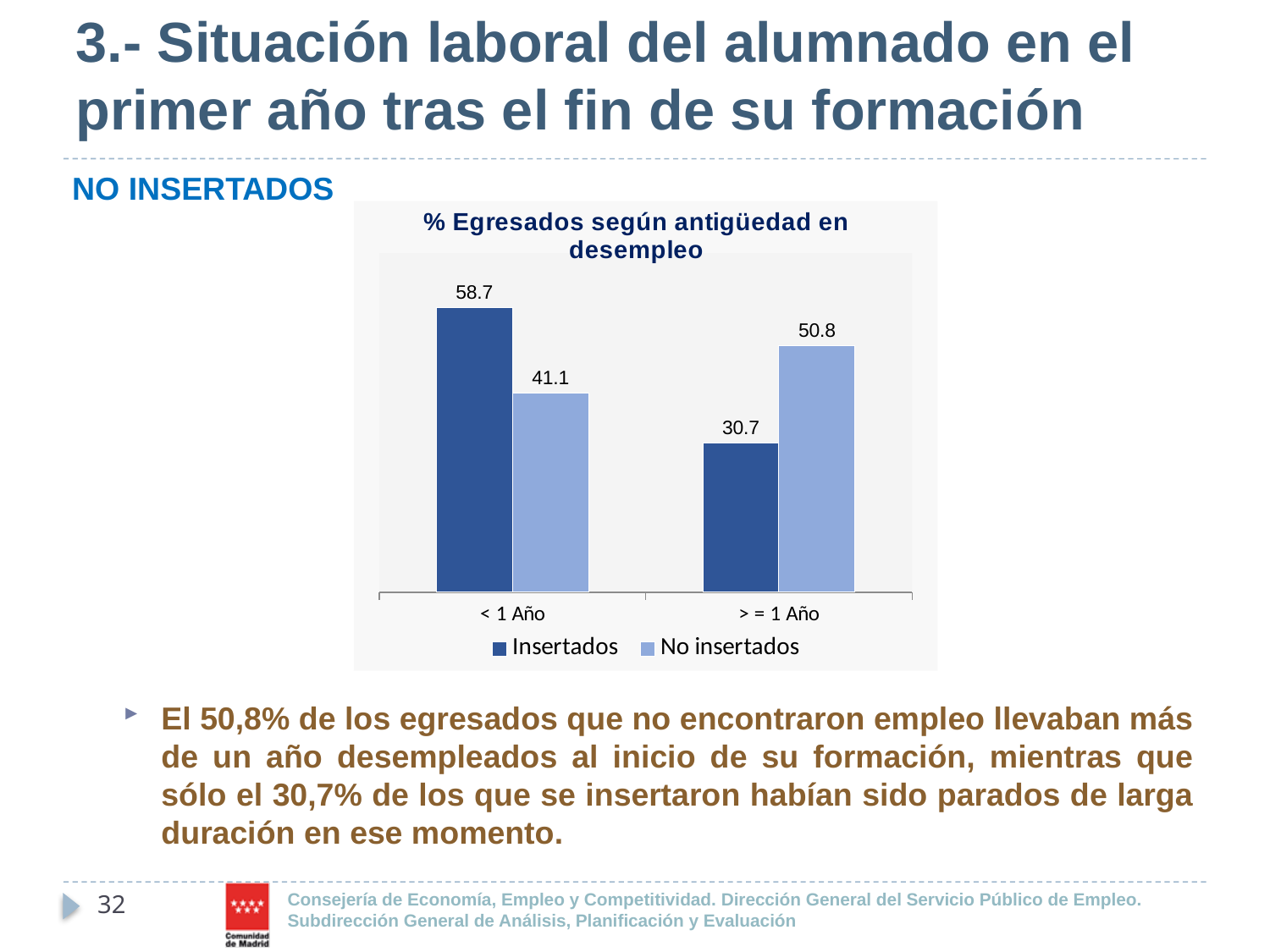
How many series does the chart legend list? 2 What is the value for Insertados in the > = 1 Año category? 30.7 Which category has the highest value for the Insertados series? < 1 Año What type of chart is shown on the slide? Bar chart What is the value for Insertados in the < 1 Año category? 58.7 What is the value for No insertados in the < 1 Año category? 41.1 What is the value for No insertados in the > = 1 Año category? 50.8 What is the difference between the No insertados and Insertados values in the > = 1 Año category? 20.1 How many categories are shown on the x axis of the chart? 2 What is the difference between the Insertados and No insertados values in the < 1 Año category? 17.6 In the > = 1 Año category, which series has the larger value, Insertados or No insertados? No insertados Which category has the lowest value for the No insertados series? < 1 Año